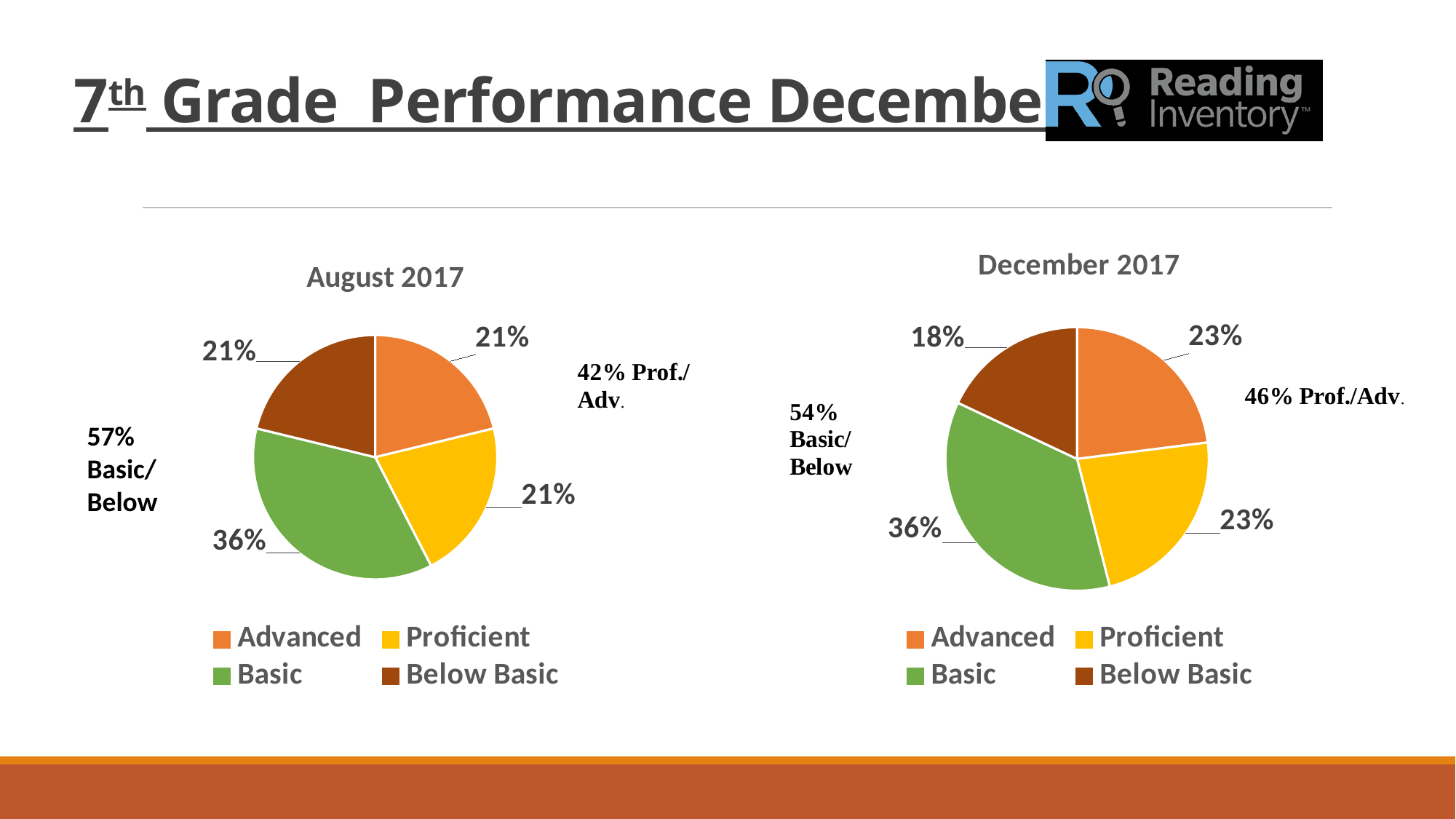
How many categories does the legend of the December 2017 chart list? 4 In the August 2017 chart, which category has the largest slice? Basic What is the difference between the Below Basic share in August 2017 and in December 2017? 3% Which is larger: the Advanced share in August 2017 or the Advanced share in December 2017? December 2017 In the August 2017 chart, what share of the pie is Basic? 36% What kind of chart is the August 2017 chart? Pie chart In the December 2017 chart, which category has the largest slice? Basic In the August 2017 chart, what share of the pie is Proficient? 21% In the December 2017 chart, which category has the smallest slice? Below Basic In the December 2017 chart, what share of the pie is Advanced? 23% In the December 2017 chart, what colour is the Proficient slice? Yellow